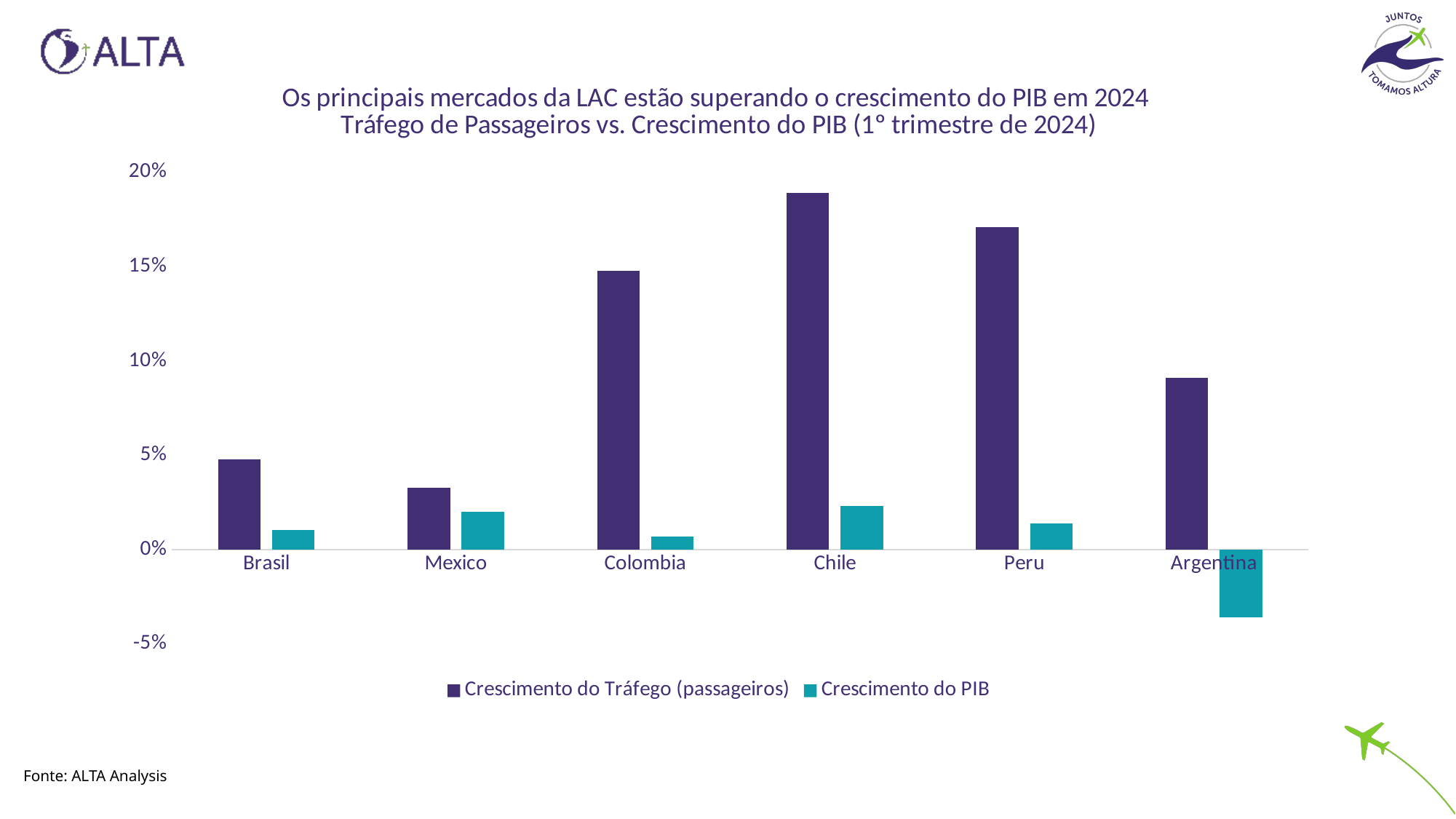
How many series does the legend list? 2 Is the Crescimento do Tráfego (passageiros) value for Argentina greater or less than 10%? less What kind of chart is shown on the slide? bar chart Is the Crescimento do Tráfego (passageiros) value for Chile greater or less than 15%? greater Which is larger for Brasil, Crescimento do Tráfego (passageiros) or Crescimento do PIB? Crescimento do Tráfego (passageiros) Which country has the lowest value for Crescimento do Tráfego (passageiros)? Mexico Which country has the highest value for Crescimento do Tráfego (passageiros)? Chile What colour are the bars for Crescimento do PIB? teal Is the Crescimento do PIB value for Argentina greater or less than 0%? less Which is larger, the Crescimento do Tráfego (passageiros) value for Colombia or for Peru? Peru Which country has the lowest value for Crescimento do PIB? Argentina How many countries are shown on the x axis of the chart? 6